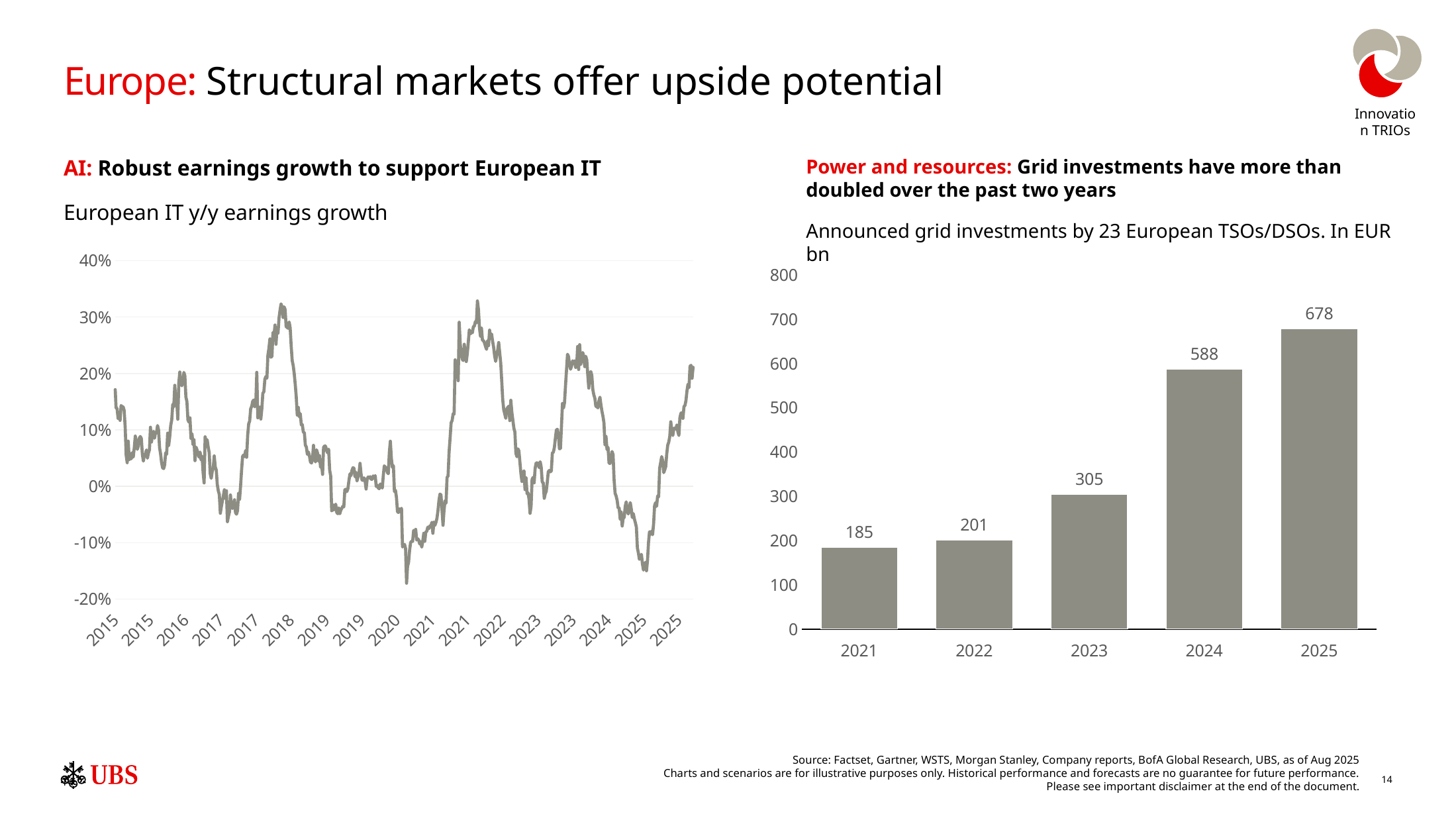
In the 'Announced grid investments by 23 European TSOs/DSOs' chart, what is the difference between the 2025 and 2024 values? 90 In the 'Announced grid investments by 23 European TSOs/DSOs' chart, which year has the highest value? 2025 In the 'Announced grid investments by 23 European TSOs/DSOs' chart, what is the value for 2023? 305 In the 'Announced grid investments by 23 European TSOs/DSOs' chart, what is the difference between the 2023 and 2022 values? 104 In the 'Announced grid investments by 23 European TSOs/DSOs' chart, what is the value for 2024? 588 How many bars are shown in the 'Announced grid investments by 23 European TSOs/DSOs' chart? 5 In the 'Announced grid investments by 23 European TSOs/DSOs' chart, is the value for 2024 larger than the value for 2023? Yes What kind of chart is the 'European IT y/y earnings growth' chart? Line chart In the 'Announced grid investments by 23 European TSOs/DSOs' chart, which year has the lowest value? 2021 In the 'Announced grid investments by 23 European TSOs/DSOs' chart, what is the value for 2021? 185 In the 'Announced grid investments by 23 European TSOs/DSOs' chart, do the values rise or fall from 2021 to 2025? Rise What kind of chart is the 'Announced grid investments by 23 European TSOs/DSOs' chart? Bar chart